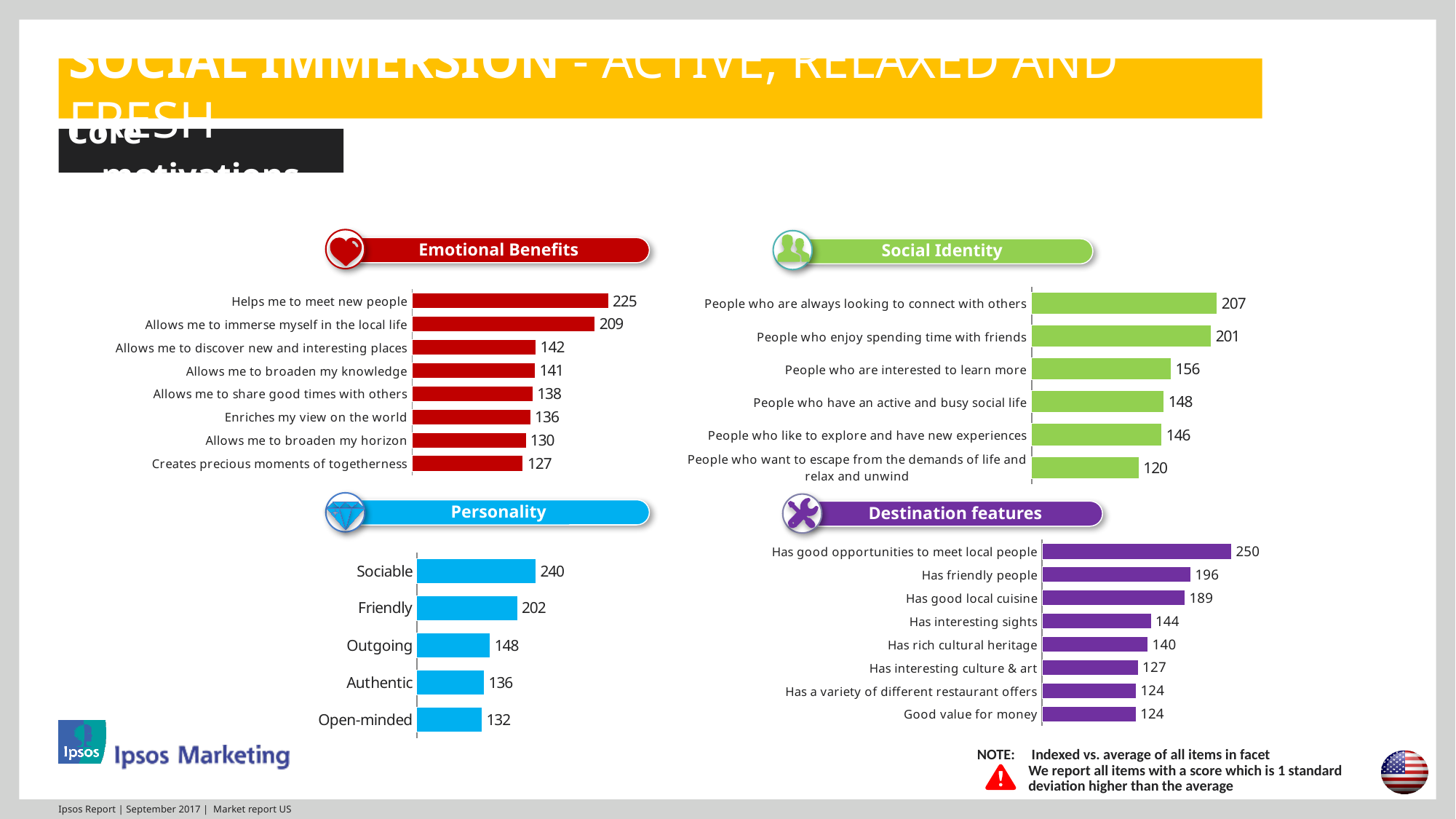
In the Social Identity chart, what is the value for "People who enjoy spending time with friends"? 201 In the Emotional Benefits chart, how many items are plotted? 8 In the Personality chart, which is larger, "Friendly" or "Authentic"? Friendly What type of chart is the Destination features chart? Bar chart In the Personality chart, how many categories are shown? 5 In the Social Identity chart, which item has the highest value? People who are always looking to connect with others In the Destination features chart, what is the value for "Has good local cuisine"? 189 In the Social Identity chart, what is the difference between "People who are always looking to connect with others" and "People who want to escape from the demands of life and relax and unwind"? 87 In the Emotional Benefits chart, which item has the lowest value? Creates precious moments of togetherness In the Personality chart, what is the value for "Outgoing"? 148 In the Destination features chart, what is the difference between "Has good opportunities to meet local people" and "Has friendly people"? 54 In the Emotional Benefits chart, what is the value for "Helps me to meet new people"? 225